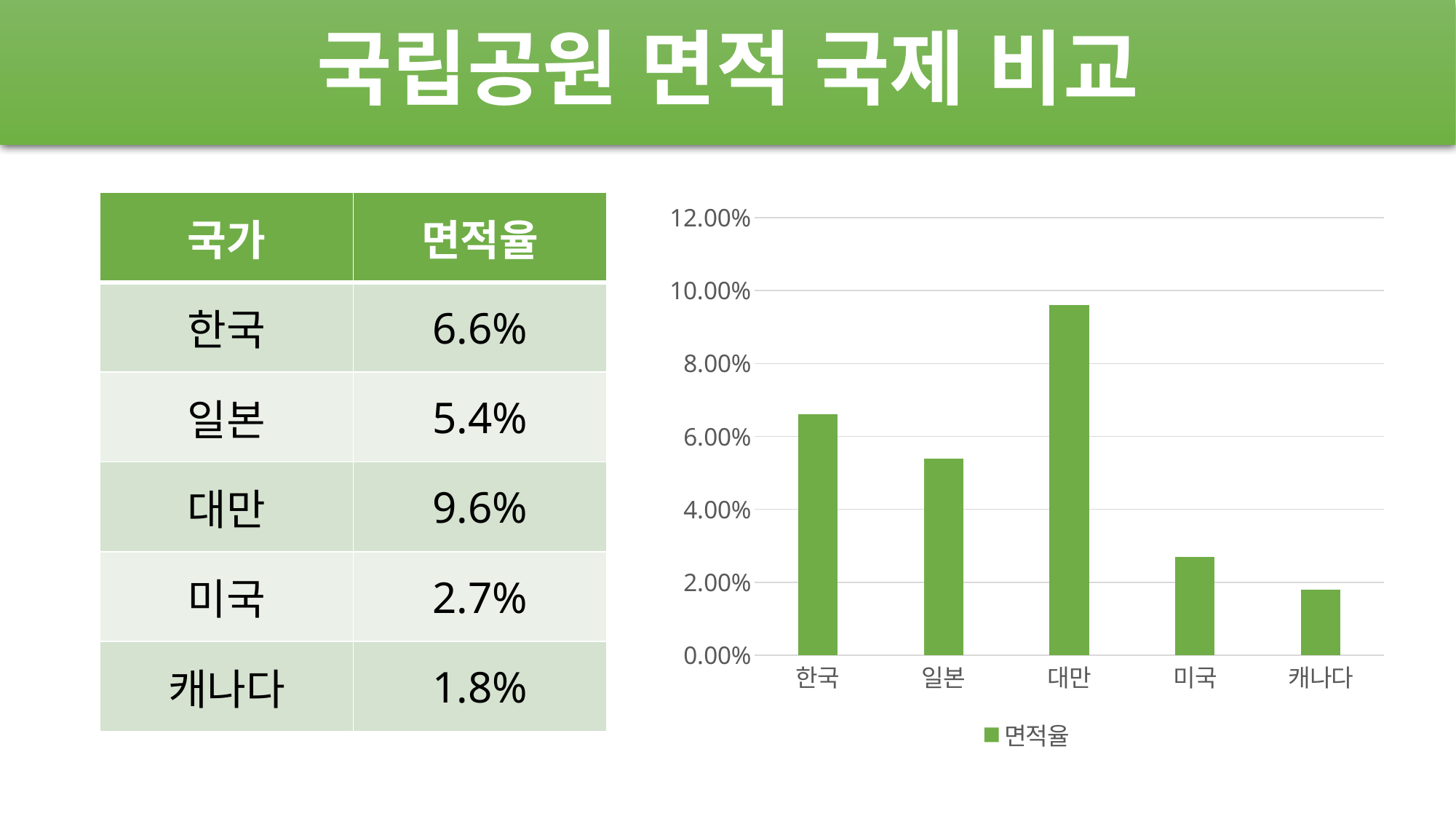
Which is larger, the value for 일본 or the value for 미국? 일본 How many series does the chart legend list? 1 What is the 면적율 value for 한국? 6.6% How many countries are plotted in the chart? 5 Is the value for 캐나다 greater or less than 2.00%? less What is the 면적율 value for 대만? 9.6% Which country has the lowest 면적율 in the chart? 캐나다 What is the legend entry of the chart? 면적율 Is the value for 대만 greater or less than 8.00%? greater What is the difference between the values for 대만 and 한국? 3.0% Which country has the highest 면적율 in the chart? 대만 What type of chart is shown on the slide? bar chart